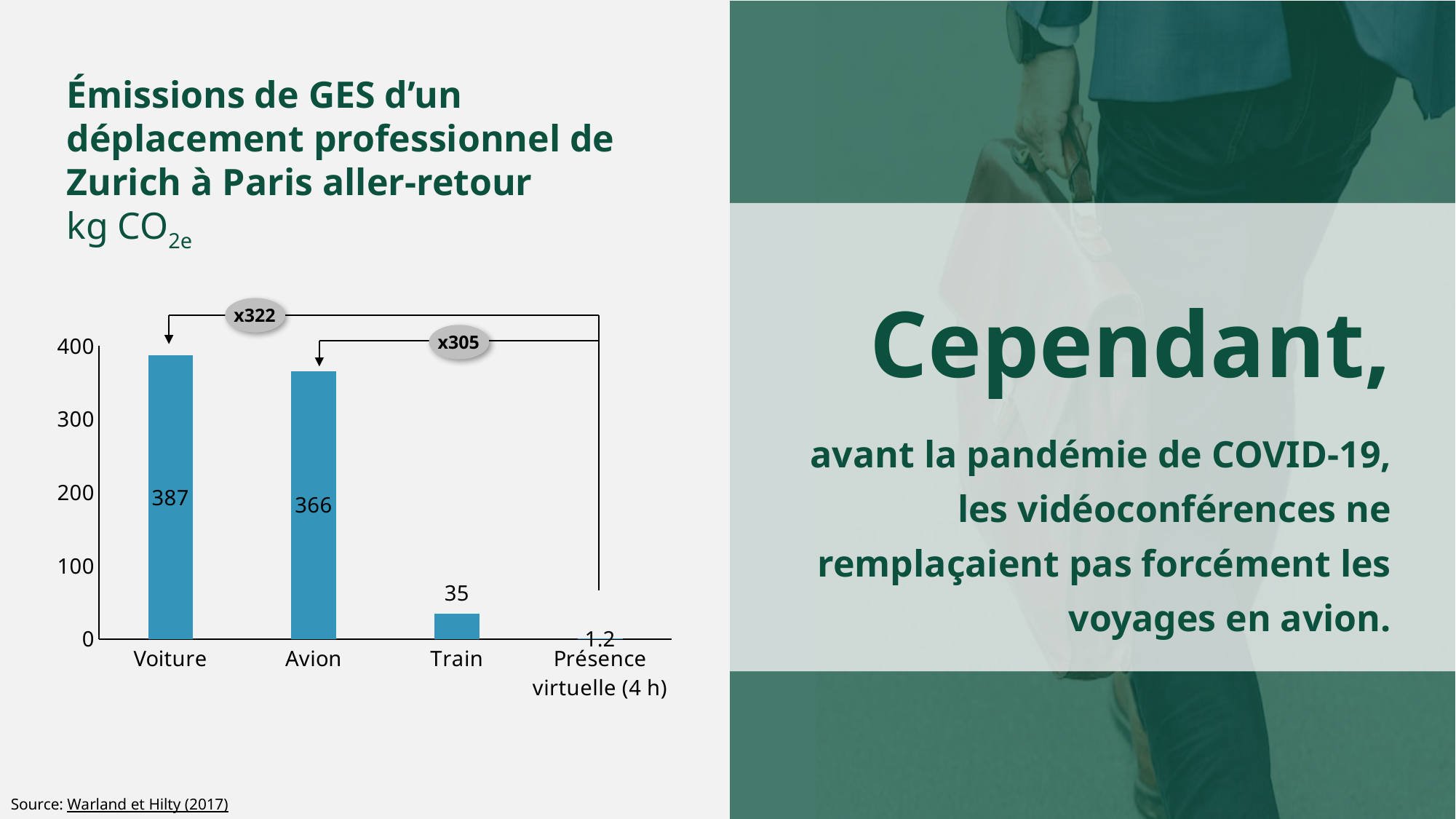
What unit is given under the chart title? kg CO2e What is the value for Voiture? 387 How many categories are shown on the x axis? 4 Which is larger, the value for Train or the value for Présence virtuelle (4 h)? Train What is the value for Avion? 366 Which category has the highest emissions? Voiture What is the value for Train? 35 What is the difference between the values for Voiture and Avion? 21 What is the value for Présence virtuelle (4 h)? 1.2 What is the difference between the values for Avion and Train? 331 Which category has the lowest emissions? Présence virtuelle (4 h) What kind of chart is shown on the slide? Bar chart